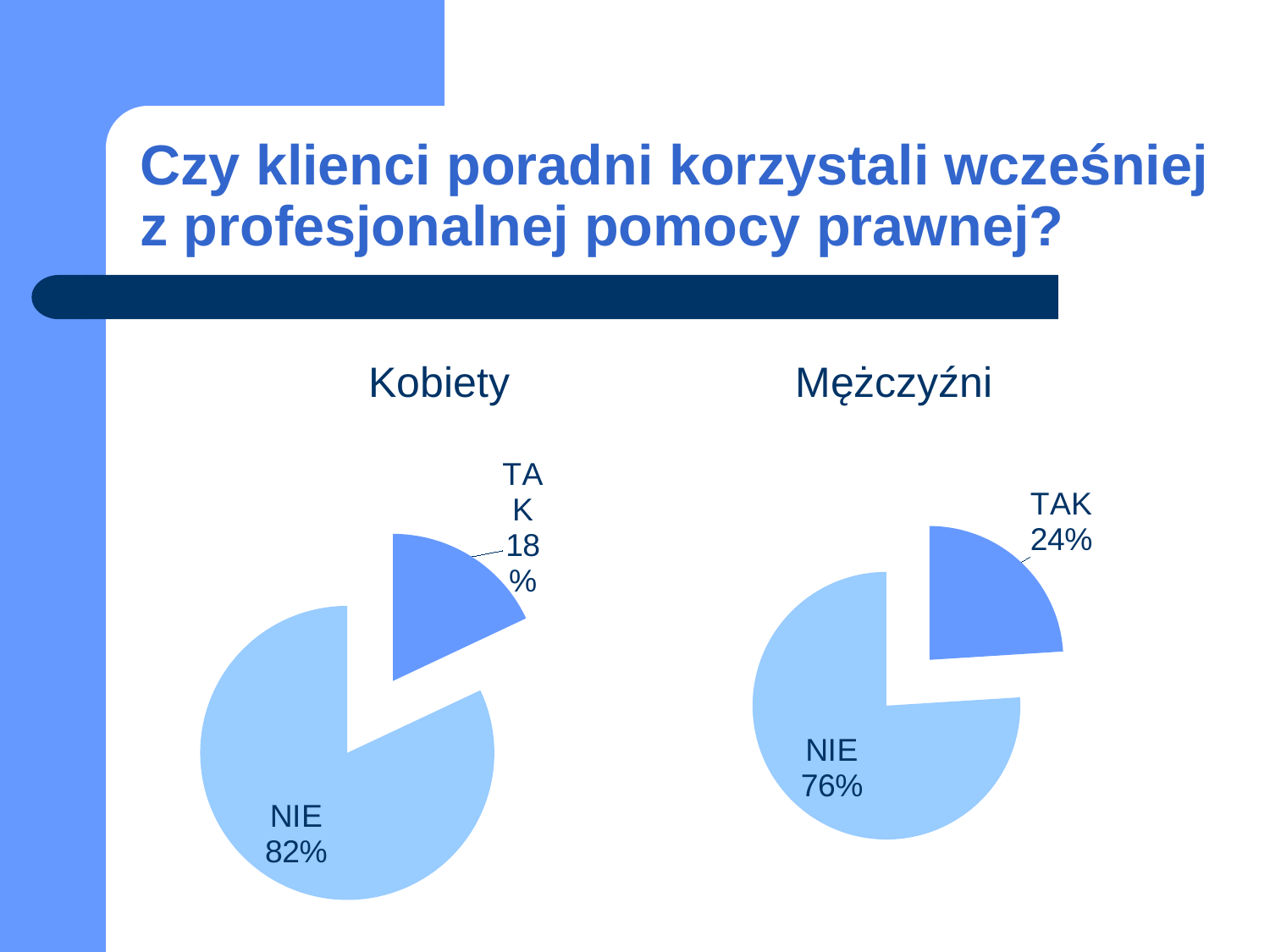
In the Kobiety chart, what is the difference between the NIE and TAK shares? 64% In the Mężczyźni chart, what share of the pie is NIE? 76% In the Kobiety chart, what share of the pie is NIE? 82% How many charts are shown on the slide? 2 What kind of chart is the Mężczyźni chart? Pie chart In the Mężczyźni chart, what is the difference between the NIE and TAK shares? 52% In the Mężczyźni chart, what share of the pie is TAK? 24% How many slices does the Kobiety chart have? 2 In the Kobiety chart, which slice is the largest? NIE Which is larger: the TAK share in the Kobiety chart or the TAK share in the Mężczyźni chart? Mężczyźni In the Mężczyźni chart, which slice is the smallest? TAK